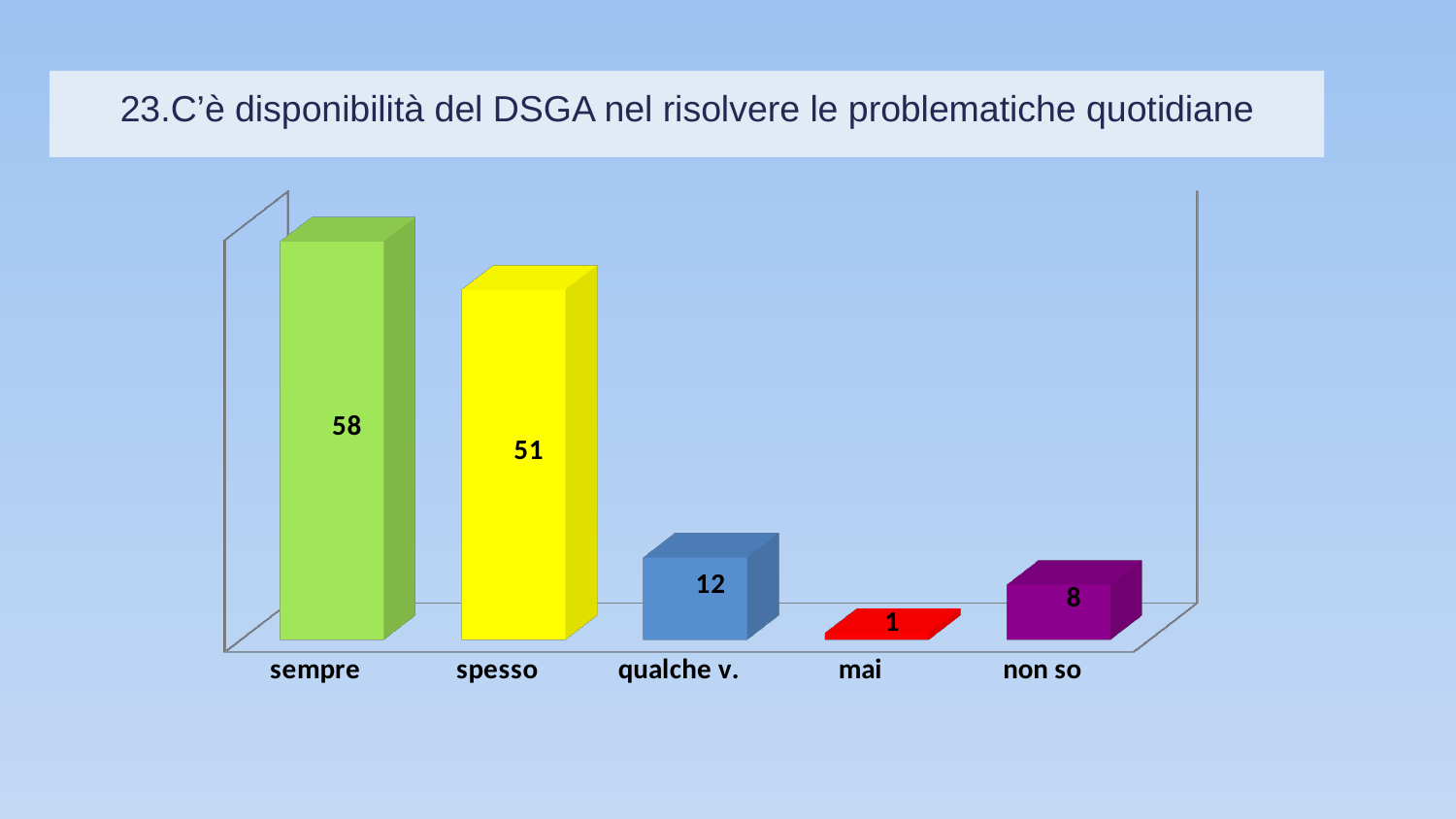
What is the value for "spesso"? 51 What is the difference between the values for "sempre" and "spesso"? 7 Which category has the lowest value? mai What is the value for "sempre"? 58 What is the value for "non so"? 8 Which category has the highest value? sempre What kind of chart is shown on the slide? bar chart What is the value for "qualche v."? 12 What colour is the bar for "spesso"? yellow What is the value for "mai"? 1 How many categories are shown on the x axis? 5 Which is larger, the value for "qualche v." or the value for "non so"? qualche v.